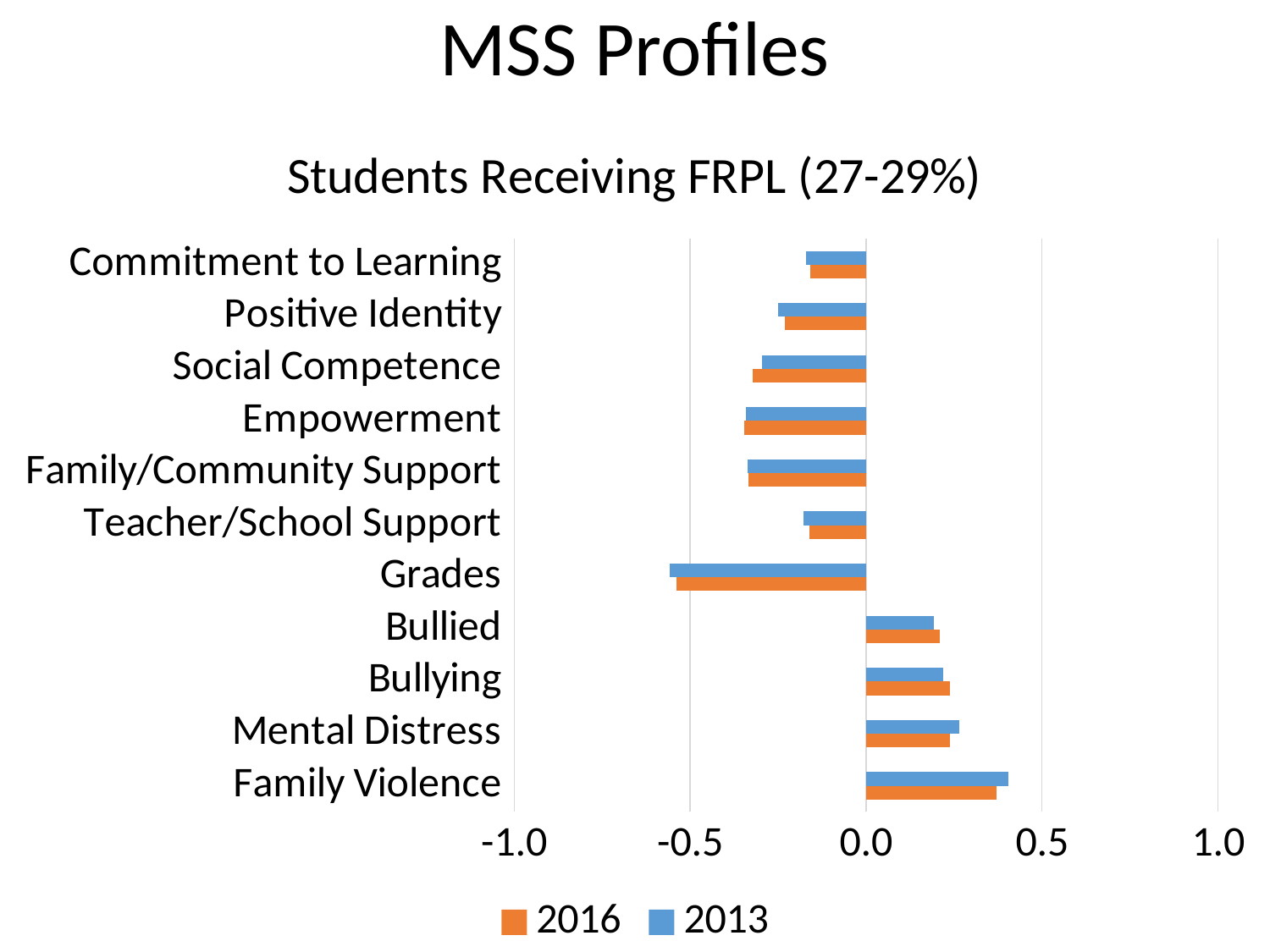
Is the 2013 value for Family Violence greater or less than 0.5? less Is the 2013 value for Grades greater or less than -0.5? less How many series does the legend list? 2 Which category has the highest value for the 2013 series? Family Violence For Family Violence, which series has the larger value, 2016 or 2013? 2013 How many categories are plotted on the chart? 11 Which category has the lowest value for the 2016 series? Grades For Mental Distress, which series has the larger value, 2016 or 2013? 2013 What is the title of the chart? Students Receiving FRPL (27-29%) What kind of chart is shown on the slide? bar chart Which category has the lowest value for the 2013 series? Grades Is the 2016 value for Commitment to Learning greater or less than -0.5? greater